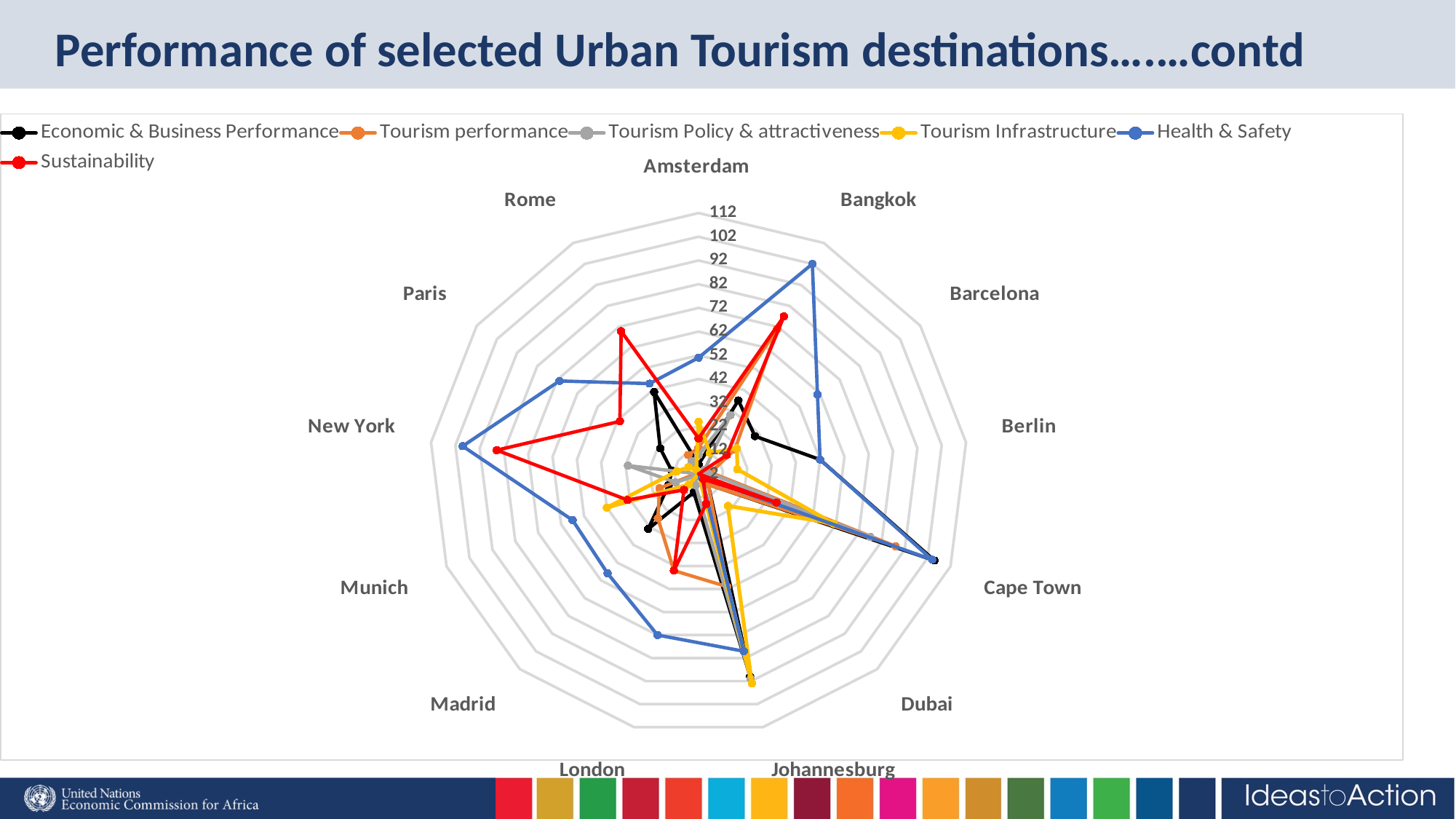
What colour is used for the Health & Safety series? blue Is the Sustainability value for New York greater or less than 72? greater Is the Health & Safety value for New York greater or less than 92? greater Which city has the higher Health & Safety value, Bangkok or Rome? Bangkok How many series does the legend list? 6 What kind of chart is shown on the slide? radar chart Which city has the higher Sustainability value, New York or Munich? New York How many cities are plotted around the radar chart? 13 Is the Health & Safety value for Bangkok greater or less than 82? greater Which city has the highest Sustainability value? New York